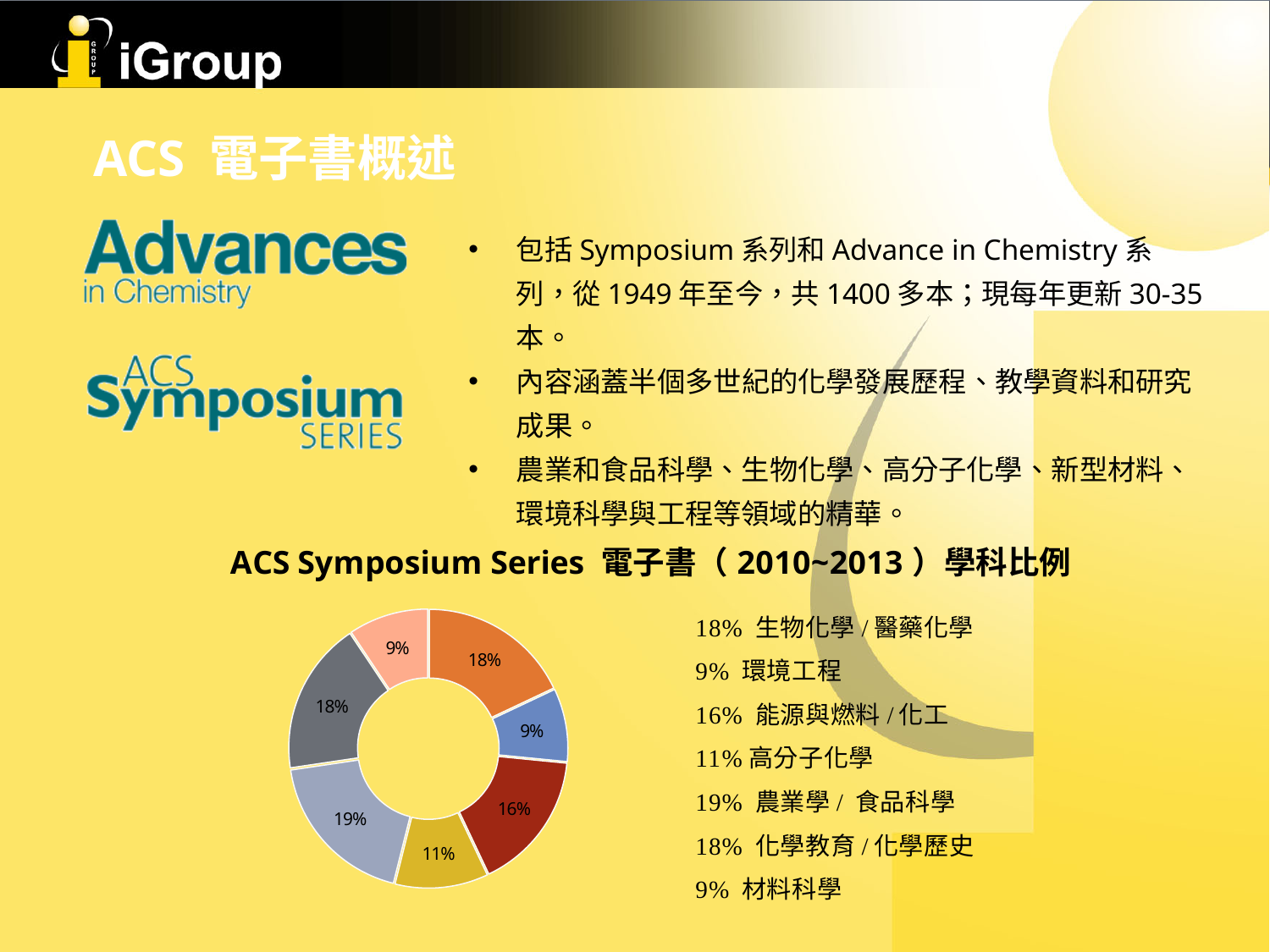
How many slices does the doughnut chart have? 7 Which has a larger share, 能源與燃料 / 化工 or 高分子化學? 能源與燃料 / 化工 Which subject area has the largest share in the chart? 農業學 / 食品科學 What percentage share does 農業學 / 食品科學 have in the chart? 19% What percentage share does 環境工程 have in the chart? 9% What is the difference in percentage points between 農業學 / 食品科學 and 高分子化學? 8 percentage points What is the title of the chart? ACS Symposium Series 電子書（2010~2013）學科比例 Which two subject areas share the smallest percentage in the chart? 環境工程 and 材料科學 What kind of chart is shown on the slide? Doughnut (pie) chart What percentage share does 能源與燃料 / 化工 have in the chart? 16% What percentage share does 高分子化學 have in the chart? 11% What is the combined share of 生物化學 / 醫藥化學 and 化學教育 / 化學歷史? 36%